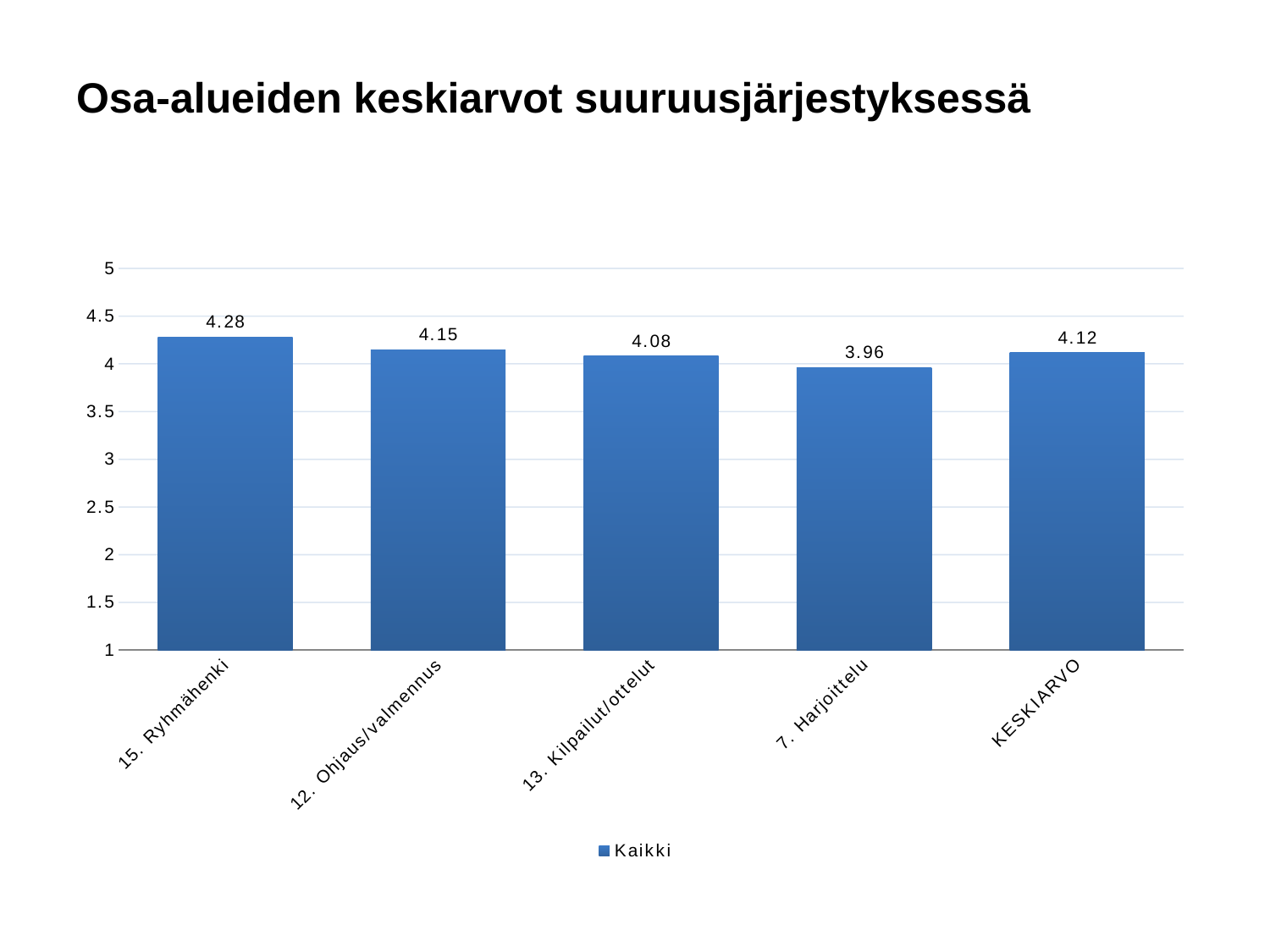
What kind of chart is shown on the slide? bar chart What is the value for 12. Ohjaus/valmennus? 4.15 Which category has the highest value? 15. Ryhmähenki What is the value for 7. Harjoittelu? 3.96 Which category has the lowest value? 7. Harjoittelu Which is larger, the value for 13. Kilpailut/ottelut or the value for KESKIARVO? KESKIARVO Is the value for 7. Harjoittelu greater or less than 4? less What is the difference between the values for 15. Ryhmähenki and 7. Harjoittelu? 0.32 What is the value for 15. Ryhmähenki? 4.28 What is the value for KESKIARVO? 4.12 What series name does the legend show? Kaikki How many categories are shown on the x axis? 5